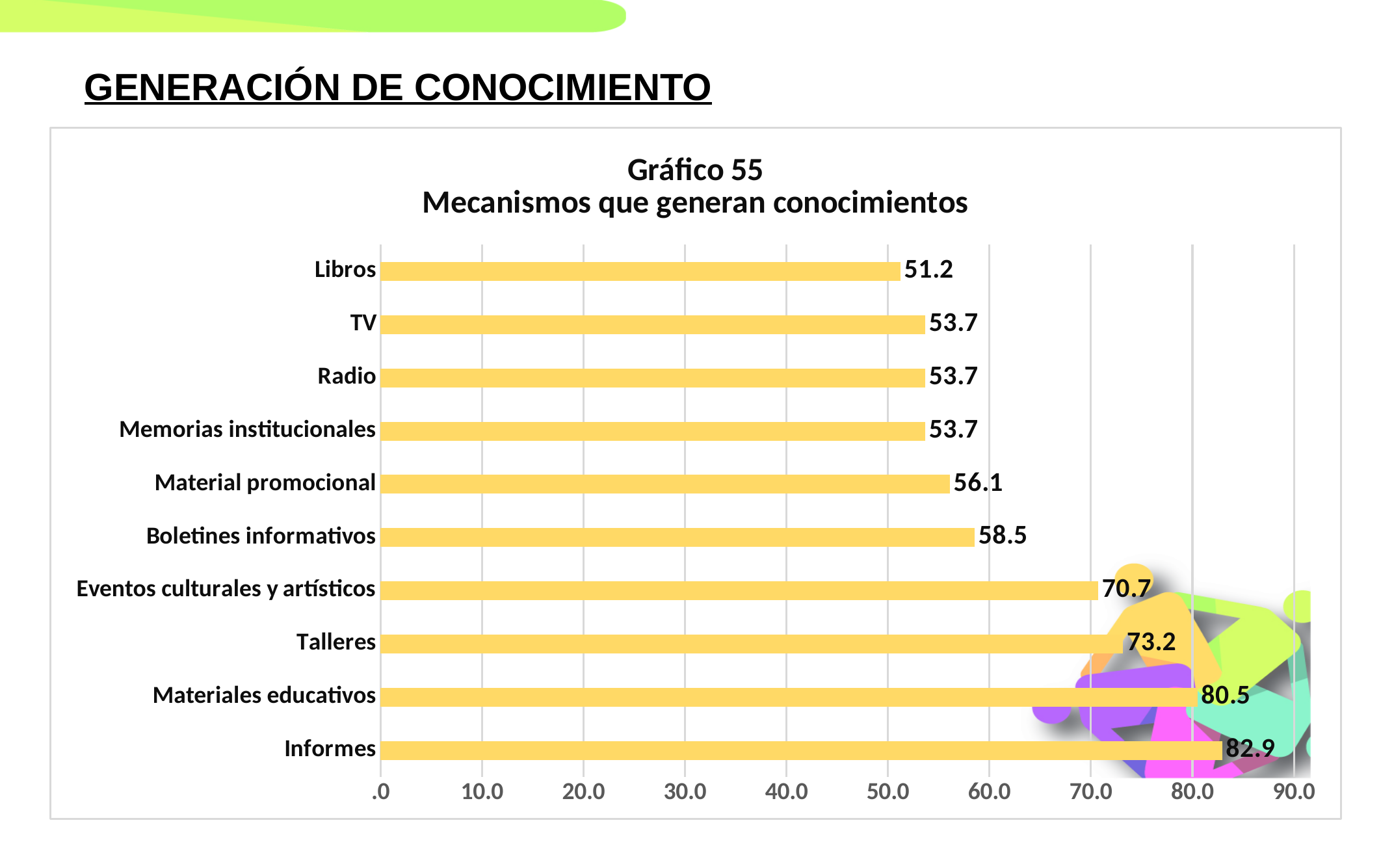
Which is larger, the value for Material promocional or the value for Libros? Material promocional What is the value for Talleres? 73.2 What is the difference between the values for Materiales educativos and Eventos culturales y artísticos? 9.8 Which category has the lowest value? Libros What kind of chart is shown on the slide? bar chart What is the value for Informes? 82.9 What is the title of the chart? Gráfico 55 Mecanismos que generan conocimientos How many categories are shown in the chart? 10 Which category has the highest value? Informes Is the value for Eventos culturales y artísticos greater or less than 60.0? greater What colour are the bars in the chart? yellow What is the value for Boletines informativos? 58.5